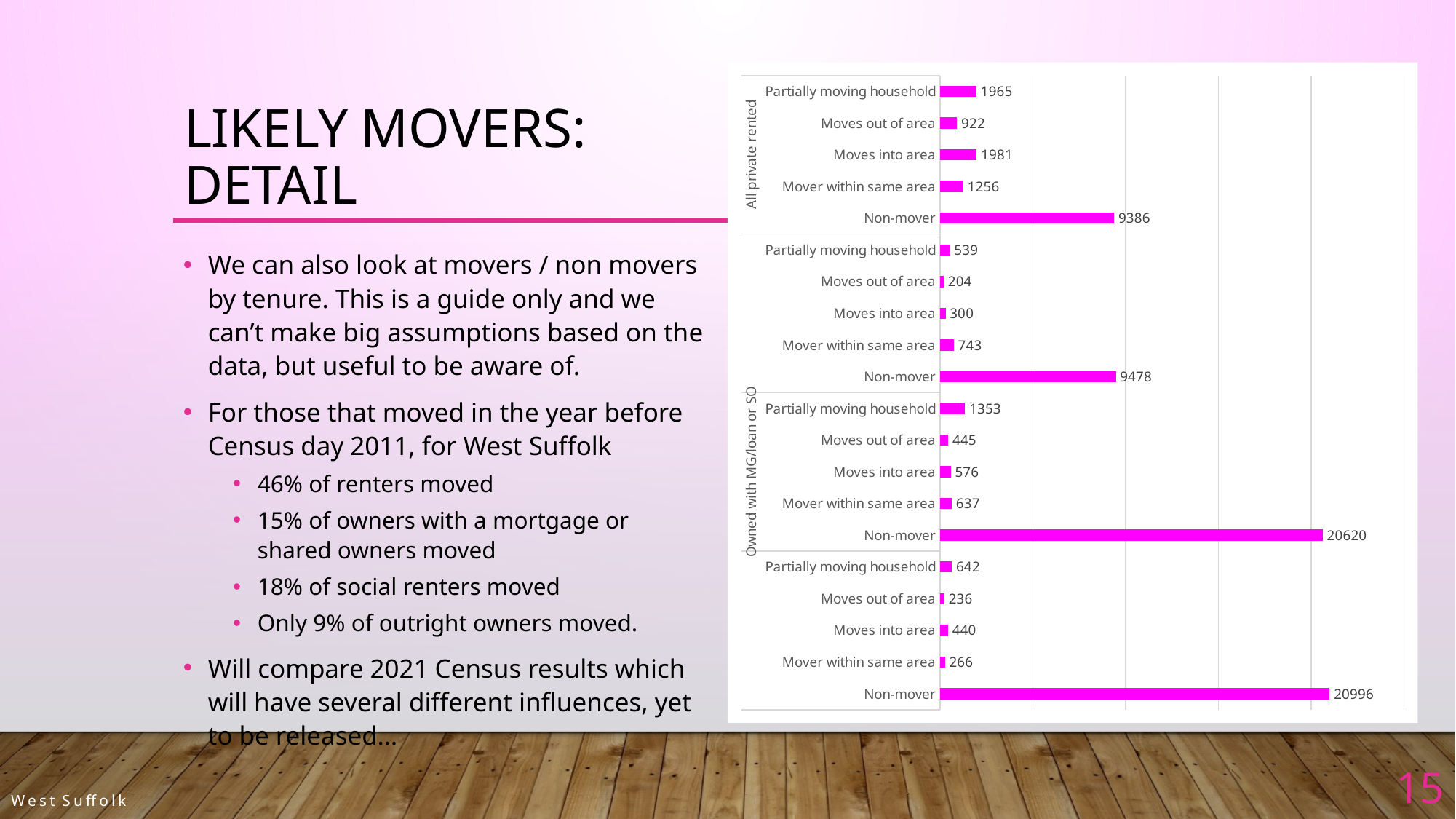
What is the difference between the Non-mover values for Owned with MG/loan or SO and All private rented? 11234 Which category in the Owned with MG/loan or SO group has the highest value? Non-mover What type of chart is shown on the slide? bar chart Which is larger: Mover within same area in the All private rented group or Mover within same area in the Owned with MG/loan or SO group? All private rented Which category in the All private rented group has the lowest value? Moves out of area In the Owned with MG/loan or SO group, what is the value for Partially moving household? 1353 How many bars are plotted in the chart in total? 20 In the Owned with MG/loan or SO group, what is the value for Moves out of area? 445 In the All private rented group, what is the value for Moves into area? 1981 What is the difference between Moves into area and Moves out of area in the All private rented group? 1059 In the Owned with MG/loan or SO group, what is the value for Non-mover? 20620 In the All private rented group, what is the value for Non-mover? 9386